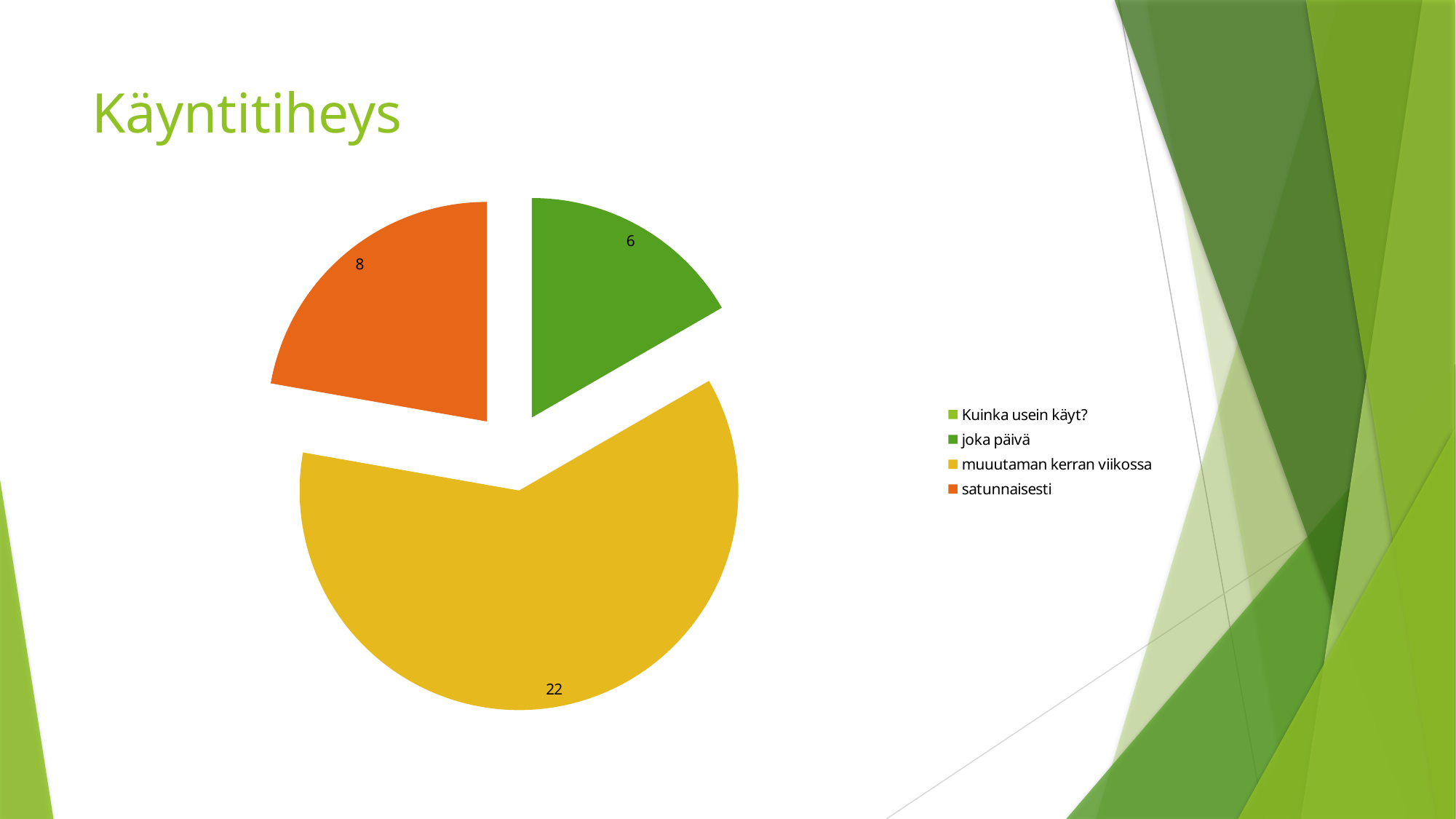
What type of chart is shown on the slide? pie chart Which category has the largest slice of the pie? muuutaman kerran viikossa Which is larger, the value for "satunnaisesti" or the value for "joka päivä"? satunnaisesti How many entries does the legend list? 4 What is the value for "joka päivä"? 6 What is the title of the slide containing the pie chart? Käyntitiheys What is the difference between the values for "satunnaisesti" and "joka päivä"? 2 How many slices are visible in the pie chart? 3 What is the value for "muuutaman kerran viikossa"? 22 What is the difference between the values for "muuutaman kerran viikossa" and "satunnaisesti"? 14 What is the value for "satunnaisesti"? 8 Which category has the smallest slice of the pie? joka päivä